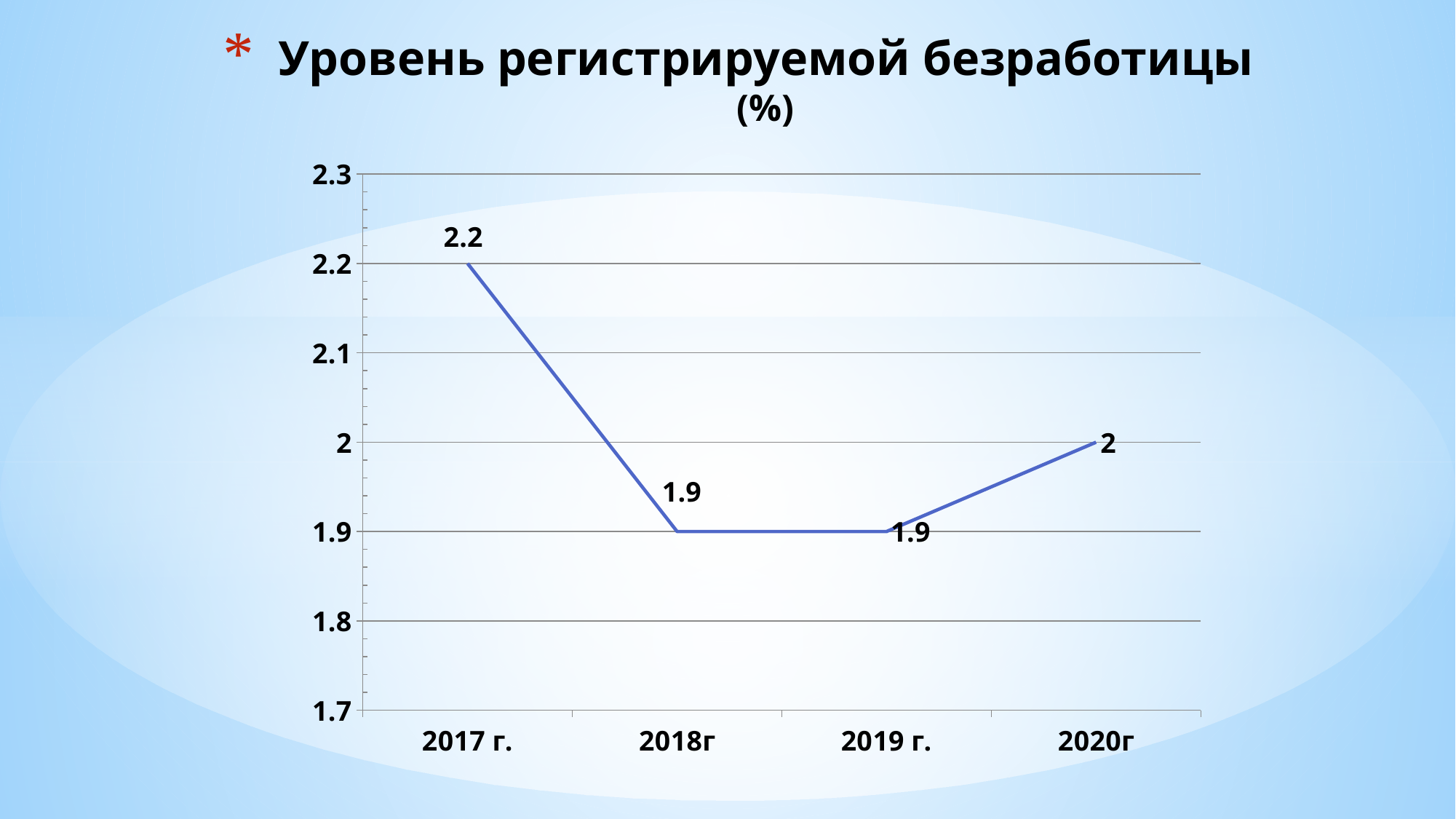
Do the values rise or fall from 2017 г. to 2018г? fall What is the difference between the values for 2020г and 2019 г.? 0.1 Which year has the highest value? 2017 г. What is the value for 2019 г.? 1.9 What is the value for 2020г? 2 What is the difference between the values for 2017 г. and 2018г? 0.3 Is the value for 2017 г. greater or less than 2.1? greater What is the value for 2017 г.? 2.2 Which is larger, the value for 2017 г. or the value for 2020г? 2017 г. How many years are plotted on the chart? 4 What kind of chart is shown on the slide? line chart What is the value for 2018г? 1.9